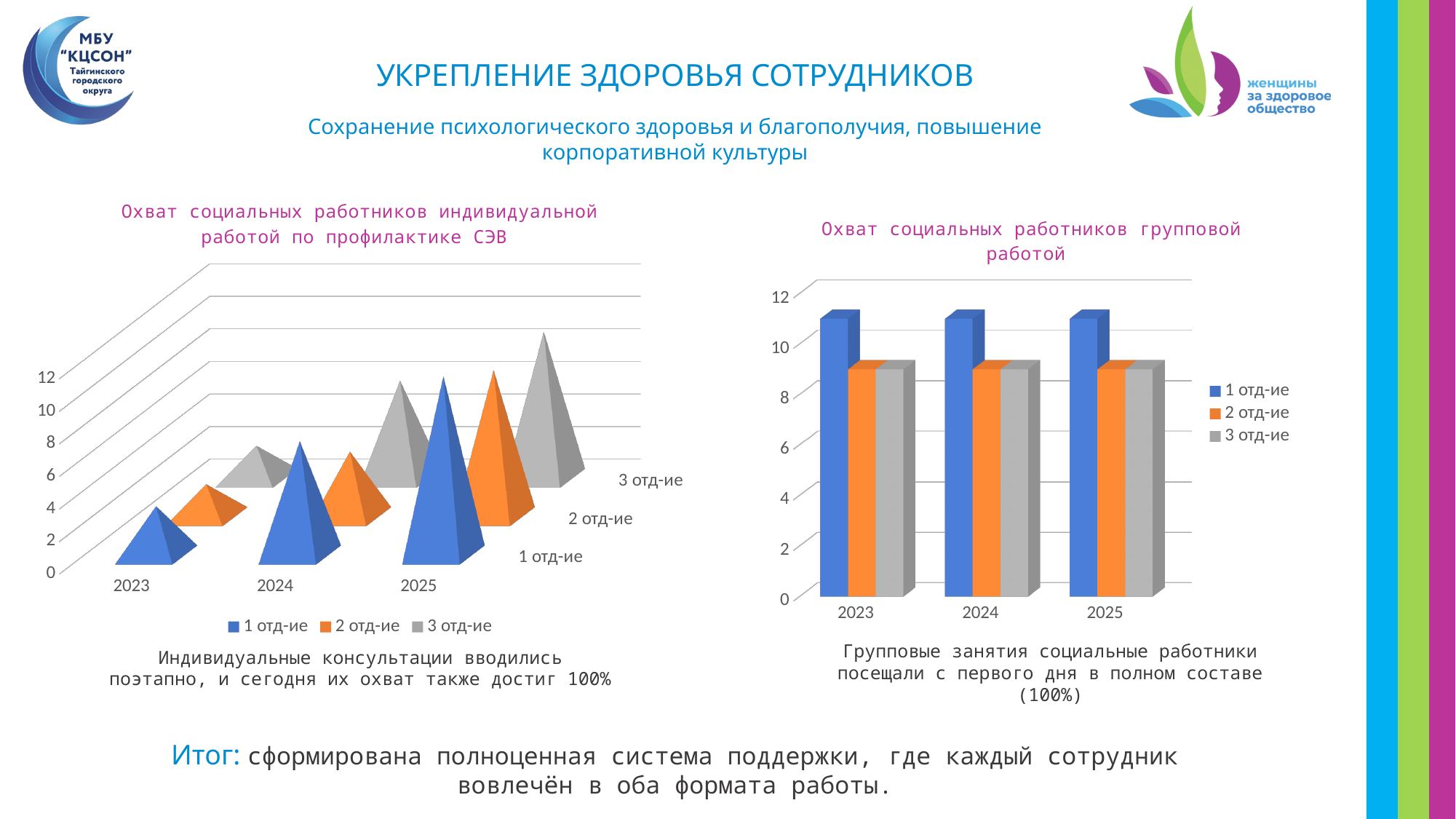
On the chart titled "Охват социальных работников групповой работой", which series has the highest value in 2024? 1 отд-ие How many year categories are shown on the x axis of the chart titled "Охват социальных работников групповой работой"? 3 On the chart titled "Охват социальных работников индивидуальной работой по профилактике СЭВ", which year has the larger value for 3 отд-ие: 2023 or 2025? 2025 On the chart titled "Охват социальных работников групповой работой", do the values for 1 отд-ие rise, fall or stay the same from 2023 to 2025? stay the same How many series does the legend list on the chart titled "Охват социальных работников групповой работой"? 3 On the chart titled "Охват социальных работников групповой работой", is the value for 1 отд-ие in 2025 greater or less than 10? greater On the chart titled "Охват социальных работников индивидуальной работой по профилактике СЭВ", do the values for 1 отд-ие rise or fall from 2023 to 2025? rise On the chart titled "Охват социальных работников групповой работой", which is larger in 2023: 1 отд-ие or 2 отд-ие? 1 отд-ие On the chart titled "Охват социальных работников групповой работой", is the value for 3 отд-ие in 2023 greater or less than 8? greater What kind of chart is the chart titled "Охват социальных работников групповой работой"? bar chart On the chart titled "Охват социальных работников групповой работой", is the value for 2 отд-ие in 2024 greater or less than 10? less How many series does the legend list on the chart titled "Охват социальных работников индивидуальной работой по профилактике СЭВ"? 3